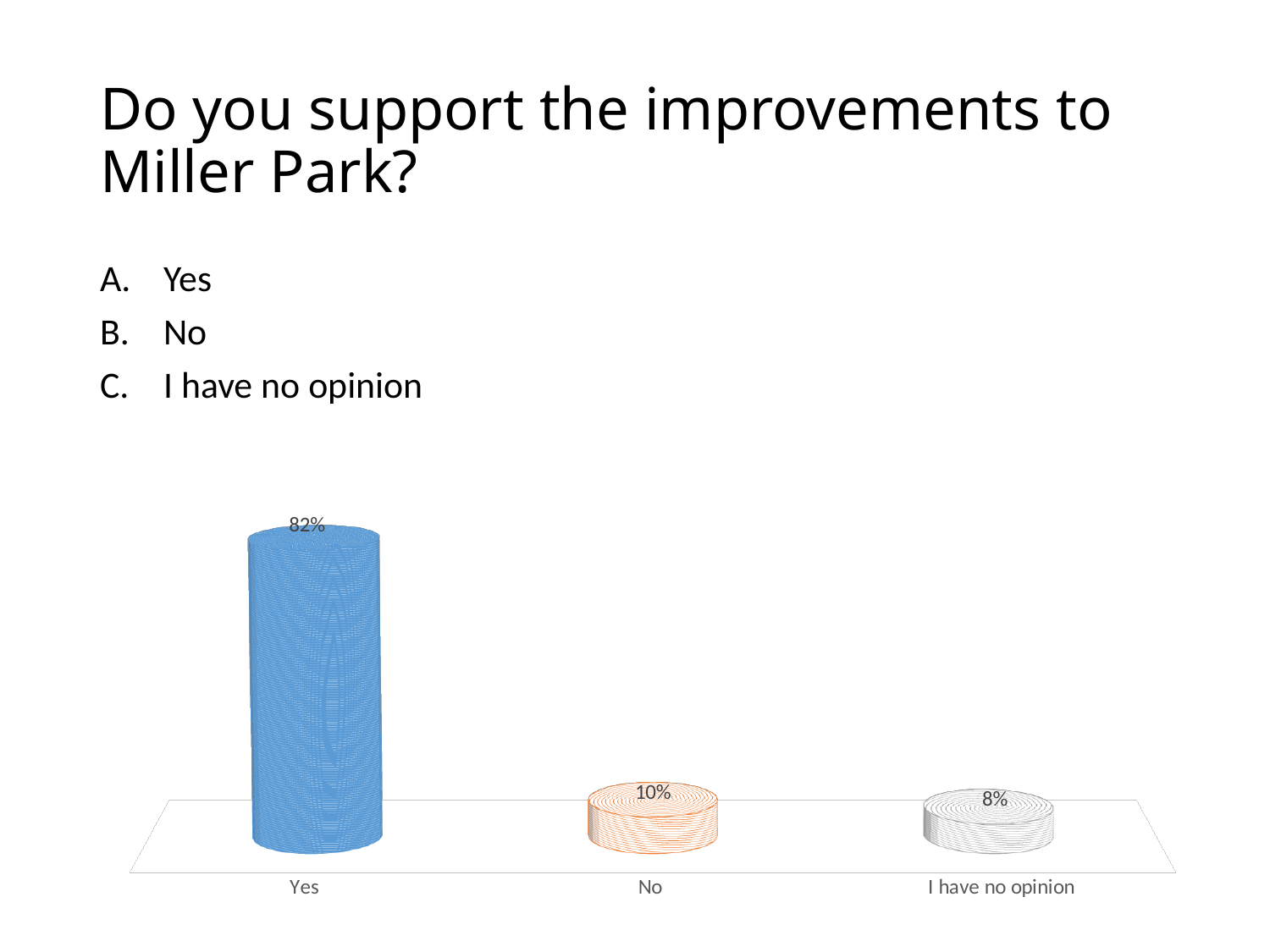
What is the value for No? 10% Which category has the lowest value? I have no opinion Which category has the highest value? Yes What kind of chart is shown on the slide? Bar chart How many categories are shown on the chart? 3 What colour is the bar for Yes? Blue What is the value for Yes? 82% What is the value for I have no opinion? 8% Which is larger, the value for Yes or the value for No? Yes What is the difference between the values for Yes and No? 72% Do the values rise or fall from left to right across the categories? Fall What is the difference between the values for No and I have no opinion? 2%